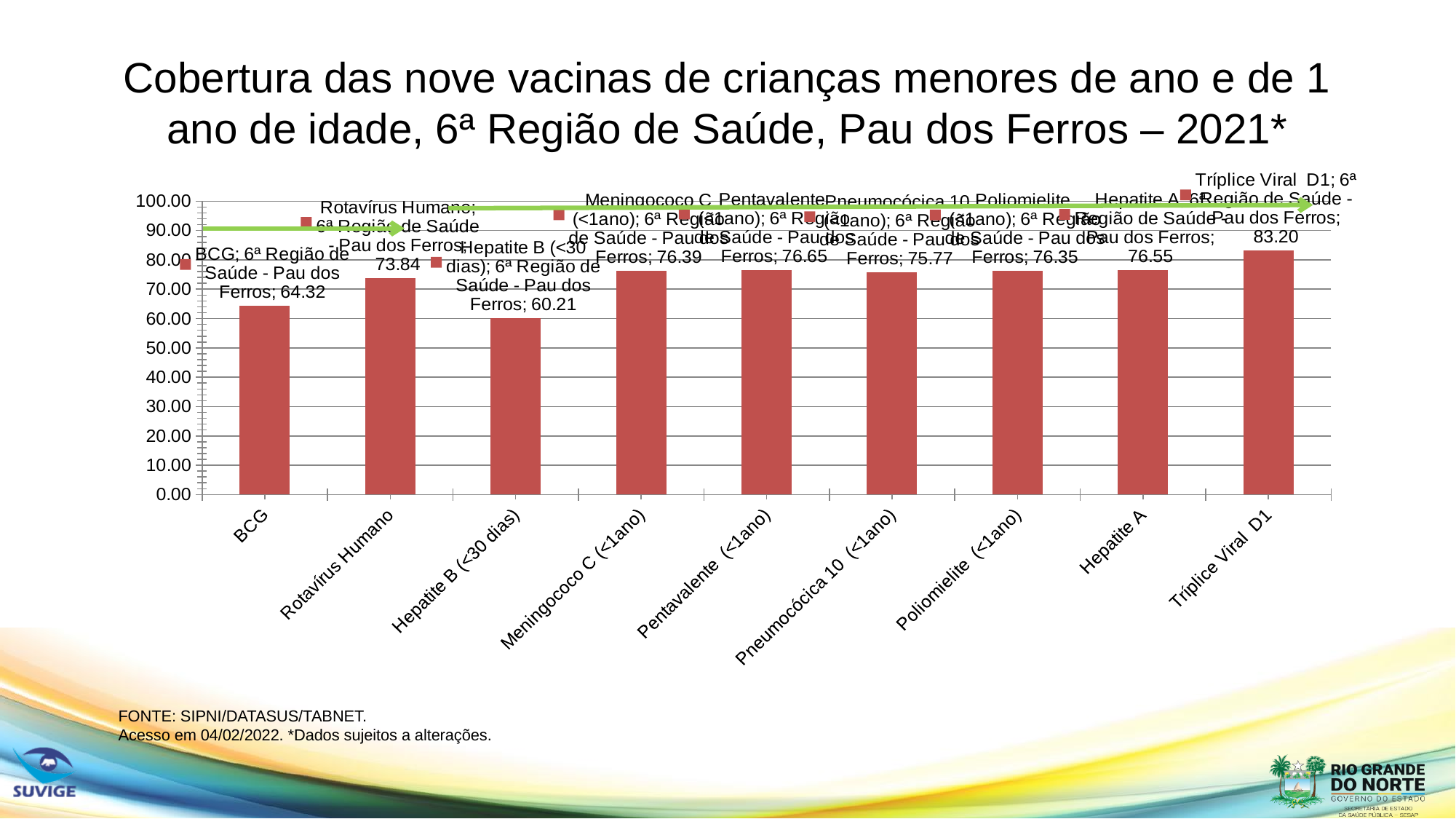
What is the value for Pentavalente (<1ano)? 76.65 What is the value for BCG? 64.32 What kind of chart is shown on the slide? bar chart What is the difference between the values for Rotavírus Humano and BCG? 9.52 What is the difference between the values for Tríplice Viral D1 and Hepatite B (<30 dias)? 22.99 What is the value for Tríplice Viral D1? 83.20 How many vaccines are shown on the x axis? 9 Which is larger, the value for BCG or the value for Rotavírus Humano? Rotavírus Humano Is the value for BCG greater or less than 60.00? greater What is the value for Hepatite B (<30 dias)? 60.21 Which vaccine has the lowest coverage value? Hepatite B (<30 dias) Which vaccine has the highest coverage value? Tríplice Viral D1